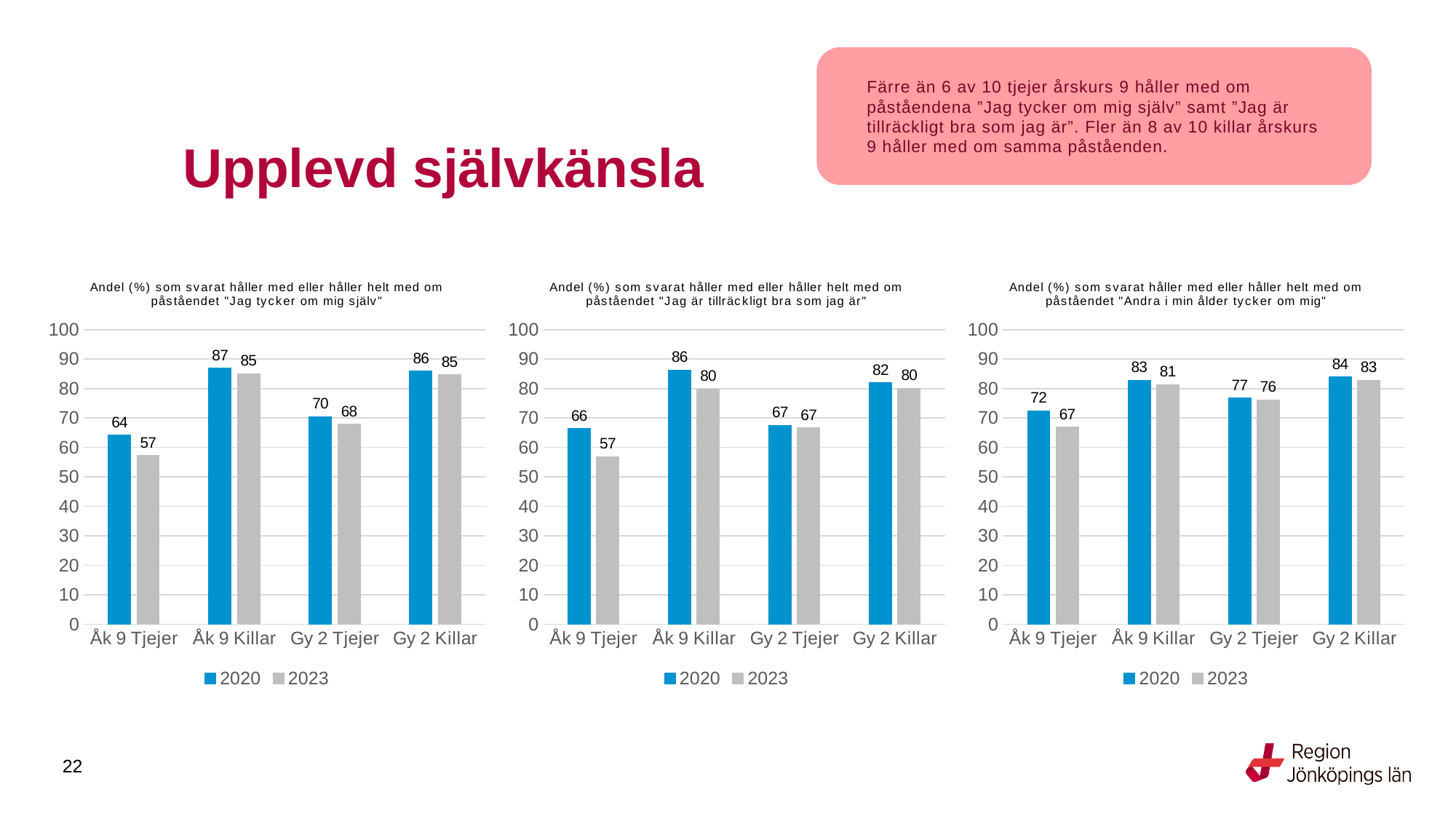
In the middle chart ("Jag är tillräckligt bra som jag är"), what is the value for Gy 2 Killar in 2020? 82 In the middle chart ("Jag är tillräckligt bra som jag är"), is the 2020 value for Åk 9 Killar larger or smaller than the 2020 value for Gy 2 Killar? larger How many series does the legend of the middle chart list? 2 In the left chart ("Jag tycker om mig själv"), which category has the highest 2020 value? Åk 9 Killar In the right chart ("Andra i min ålder tycker om mig"), what is the difference between the 2020 and 2023 values for Gy 2 Tjejer? 1 What kind of chart is the right chart? bar chart In the right chart ("Andra i min ålder tycker om mig"), what is the value for Åk 9 Tjejer in 2020? 72 How many categories are shown on the x axis of the left chart? 4 In the right chart ("Andra i min ålder tycker om mig"), which category has the highest 2023 value? Gy 2 Killar In the left chart ("Jag tycker om mig själv"), what is the value for Åk 9 Tjejer in 2023? 57 In the middle chart ("Jag är tillräckligt bra som jag är"), which category has the lowest 2023 value? Åk 9 Tjejer In the left chart ("Jag tycker om mig själv"), what is the difference between the 2020 and 2023 values for Åk 9 Tjejer? 7